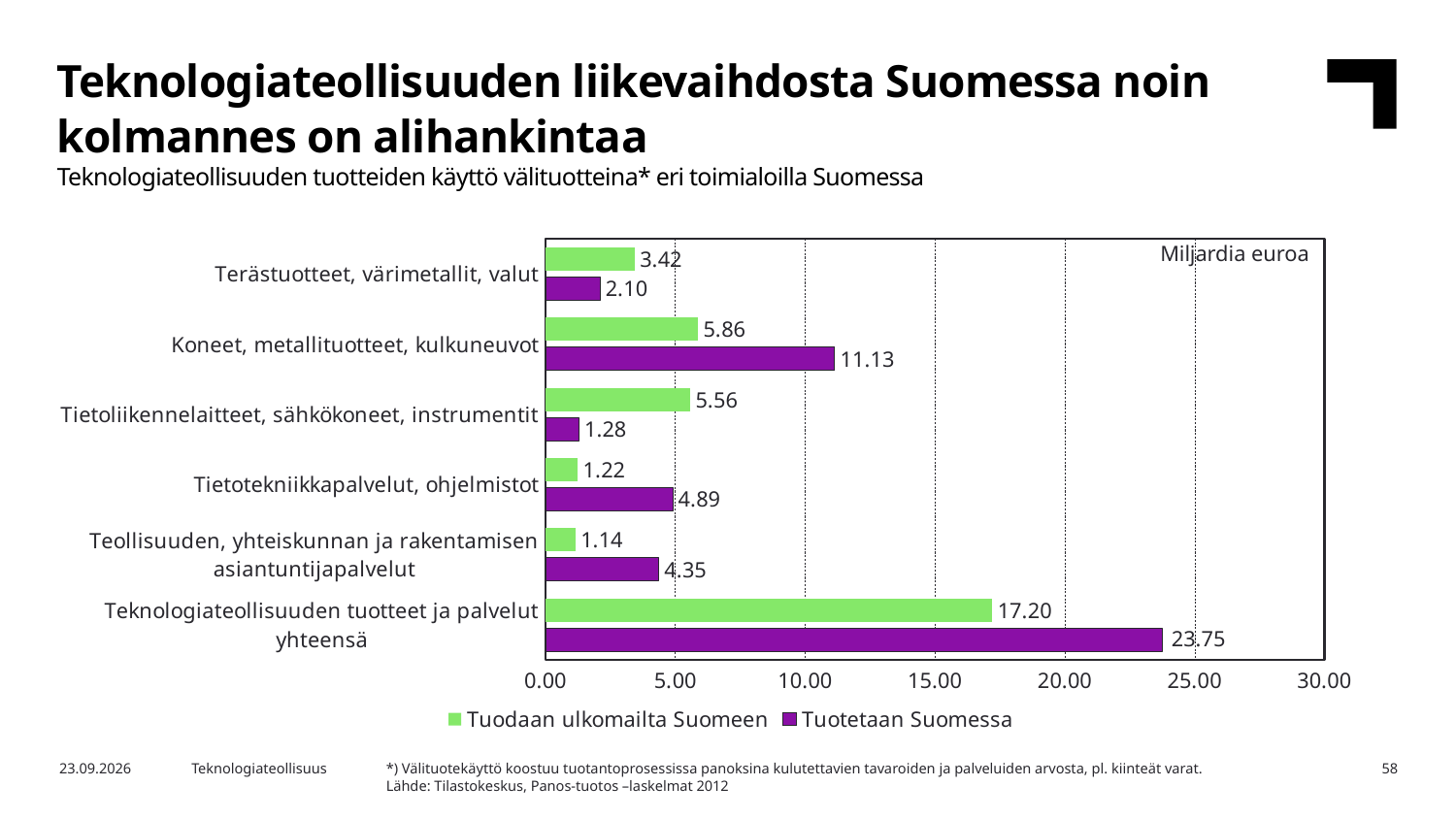
How many series does the legend list? 2 How many categories are shown on the chart? 6 Is the value of "Tuotetaan Suomessa" for Tietotekniikkapalvelut, ohjelmistot greater or less than 5.00? less For Terästuotteet, värimetallit, valut, which is larger: "Tuodaan ulkomailta Suomeen" or "Tuotetaan Suomessa"? Tuodaan ulkomailta Suomeen What kind of chart is shown on the slide? Bar chart What is the value of "Tuotetaan Suomessa" for Koneet, metallituotteet, kulkuneuvot? 11.13 What is the value of "Tuodaan ulkomailta Suomeen" for Tietoliikennelaitteet, sähkökoneet, instrumentit? 5.56 What is the value of "Tuotetaan Suomessa" for Teknologiateollisuuden tuotteet ja palvelut yhteensä? 23.75 What is the difference between "Tuotetaan Suomessa" and "Tuodaan ulkomailta Suomeen" for Teknologiateollisuuden tuotteet ja palvelut yhteensä? 6.55 Excluding the total row (yhteensä), which category has the highest value for "Tuotetaan Suomessa"? Koneet, metallituotteet, kulkuneuvot Which category has the lowest value for "Tuodaan ulkomailta Suomeen"? Teollisuuden, yhteiskunnan ja rakentamisen asiantuntijapalvelut What unit is indicated in the top right corner of the chart? Miljardia euroa